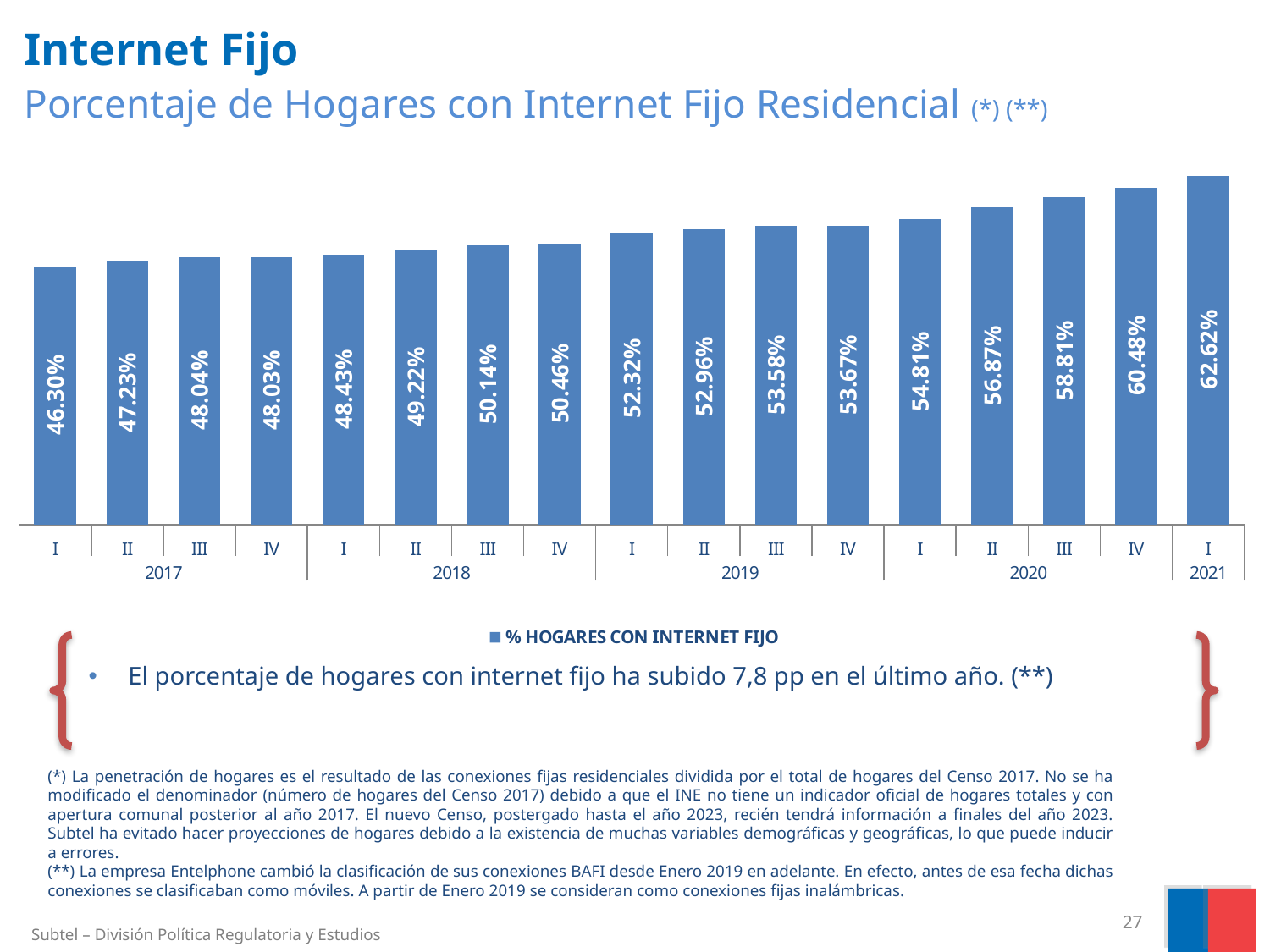
Which quarter has the lowest percentage of households with fixed internet? I 2017 What is the value for quarter I of 2017? 46.30% What kind of chart is shown on the slide? Bar chart What is the difference between the values for quarter I of 2021 and quarter I of 2020? 7.81 pp What is the value for quarter III of 2019? 53.58% How many bars are plotted in the chart? 17 How many series does the legend list? 1 What is the value for quarter II of 2020? 56.87% Do the values generally rise or fall from quarter I of 2017 to quarter I of 2021? Rise What is the value for quarter I of 2021? 62.62% Which is larger, the value for quarter IV of 2018 or the value for quarter I of 2019? I 2019 Which quarter has the highest percentage of households with fixed internet? I 2021